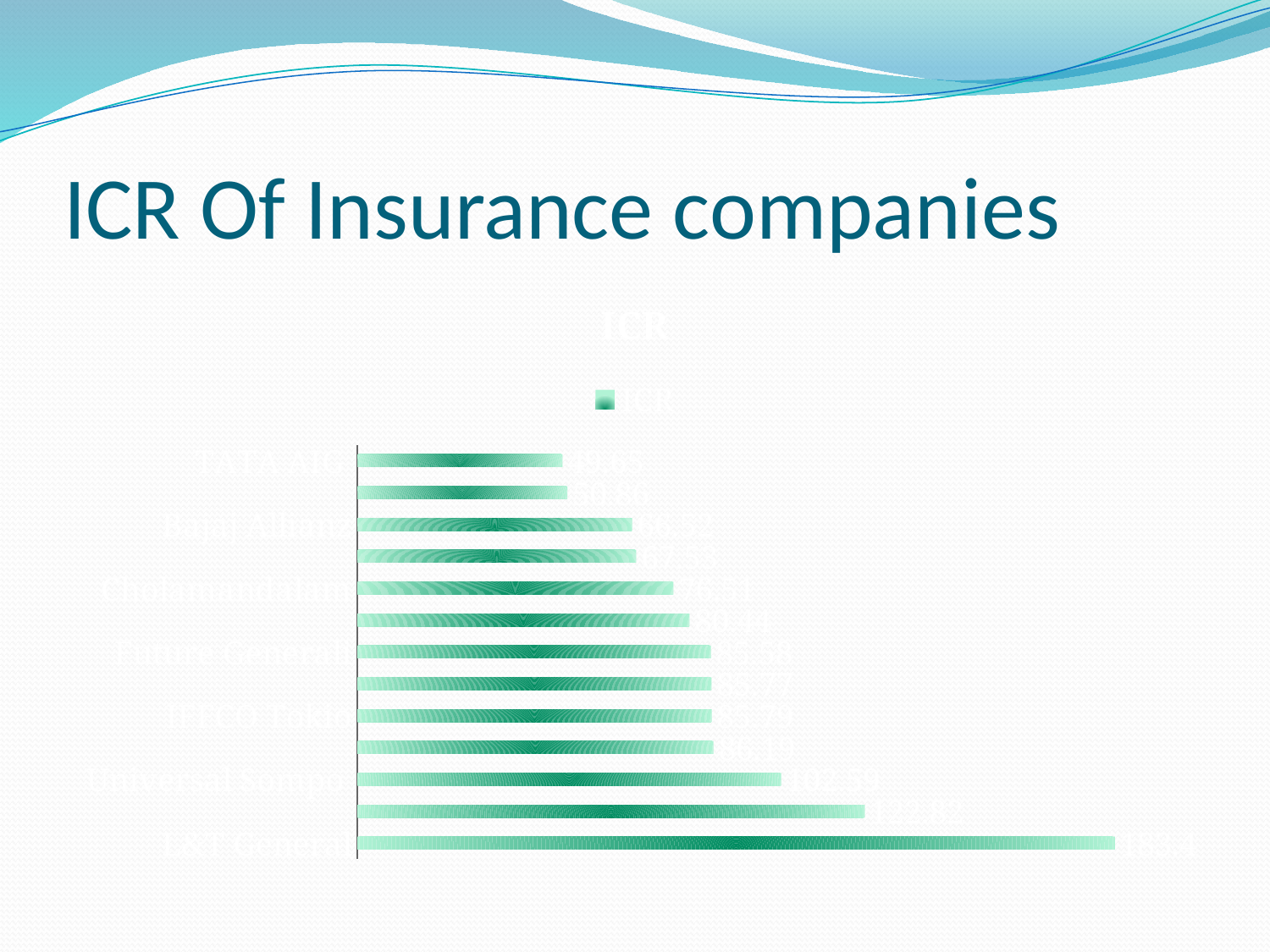
Which company has the lowest ICR value in the chart? TATA AIG How many bars are plotted in the ICR chart? 13 What kind of chart is shown on the slide? bar chart What is the ICR value for Universal Sompo? 102.59 Do the ICR values increase or decrease going from the top bar to the bottom bar? increase How many series does the legend of the ICR chart list? 1 What is the ICR value for TATA AIG? 49.65 What is the title of the chart on the slide? ICR What is the legend entry shown in the ICR chart? ICR Which has the larger ICR value, Universal Sompo or Cholamandalam? Universal Sompo Which company has the highest ICR value in the chart? L&T General What is the ICR value for L&T General? 183.4